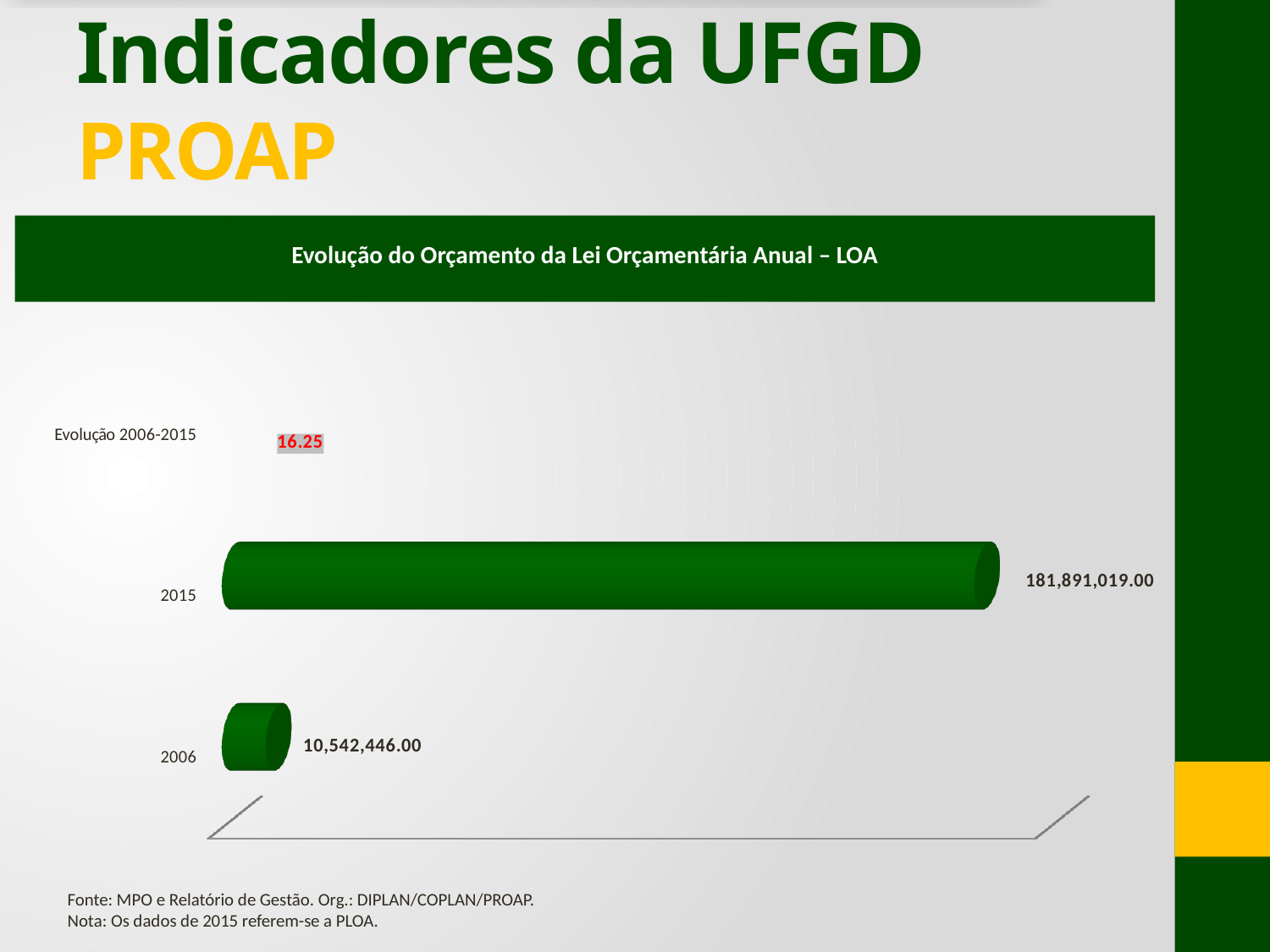
What is the title of the chart? Evolução do Orçamento da Lei Orçamentária Anual – LOA What kind of chart is shown on the slide? Bar chart What is the difference between the values for 2015 and 2006? 171,348,573.00 Which category has the highest value in the chart? 2015 What value is shown for the category 'Evolução 2006-2015'? 16.25 What is the value shown for 2015? 181,891,019.00 What is the value shown for 2006? 10,542,446.00 Which category has the lowest value in the chart? Evolução 2006-2015 How many categories are plotted in the chart? 3 What colour are the bars in the chart? Green Which year has the larger value, 2006 or 2015? 2015